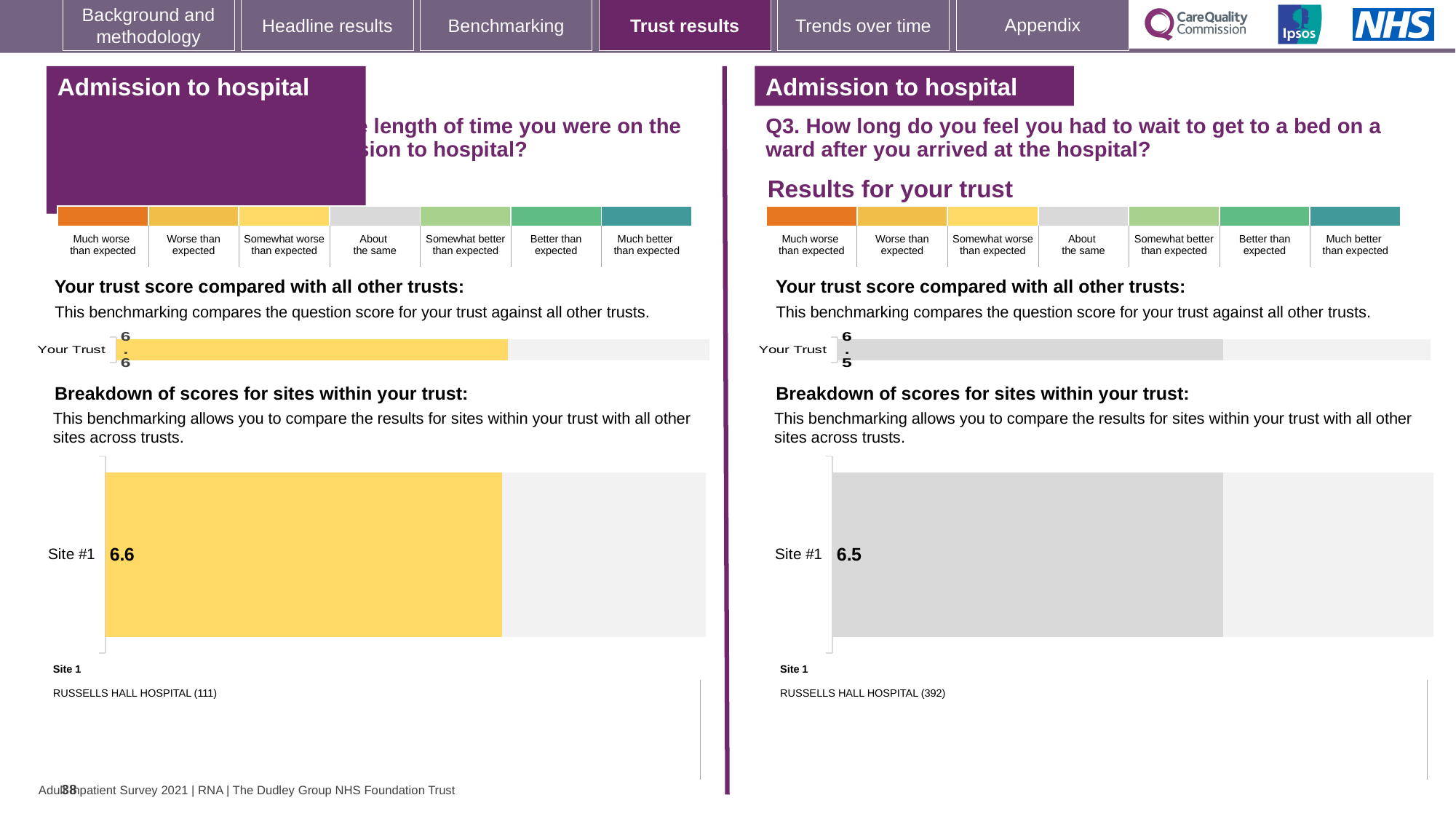
Comparing the Site #1 bars, is the score on the left-hand breakdown chart or the right-hand breakdown chart (Q3) larger? Left-hand chart What colour is the Site #1 bar on the left-hand breakdown chart? Yellow How many sites are plotted on the left-hand 'Breakdown of scores for sites within your trust' chart? 1 On the left-hand 'Your trust score compared with all other trusts' chart, what is the value shown for Your Trust? 6.6 According to the colour key, which benchmark category does the grey Site #1 bar on the right-hand breakdown chart (Q3) correspond to? About the same How many sites are plotted on the right-hand 'Breakdown of scores for sites within your trust' chart (Q3)? 1 On the right-hand 'Breakdown of scores for sites within your trust' chart (Q3), what is the score for Site #1? 6.5 What is the difference between the Site #1 score on the left-hand breakdown chart and the Site #1 score on the right-hand breakdown chart (Q3)? 0.1 On the right-hand 'Your trust score compared with all other trusts' chart (Q3), what is the value shown for Your Trust? 6.5 On the left-hand 'Breakdown of scores for sites within your trust' chart, what is the score for Site #1? 6.6 What kind of chart is the left-hand 'Breakdown of scores for sites within your trust' chart? Bar chart